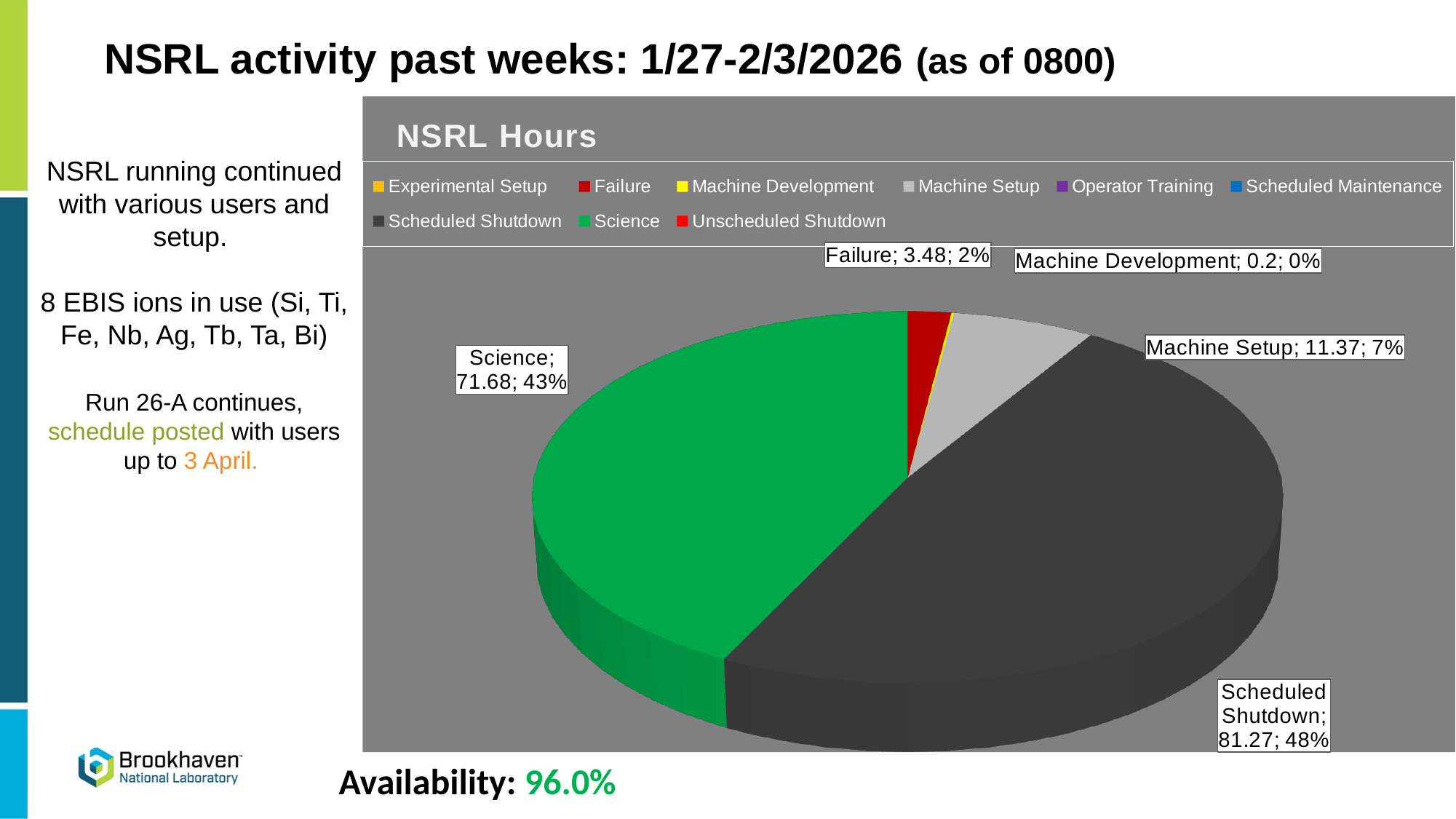
How many hours are labelled for Scheduled Shutdown in the NSRL Hours chart? 81.27 Which labelled category has the largest slice in the NSRL Hours chart? Scheduled Shutdown What is the difference in hours between Scheduled Shutdown and Science in the NSRL Hours chart? 9.59 How many hours are labelled for Failure in the NSRL Hours chart? 3.48 What kind of chart is shown on the slide? pie chart How many hours are labelled for Science in the NSRL Hours chart? 71.68 How many hours are labelled for Machine Setup in the NSRL Hours chart? 11.37 What percentage share of the pie does Science have? 43% What is the title of the pie chart? NSRL Hours What percentage share of the pie does Scheduled Shutdown have? 48% Which labelled category has the smallest slice in the NSRL Hours chart? Machine Development How many entries does the legend of the NSRL Hours chart list? 9